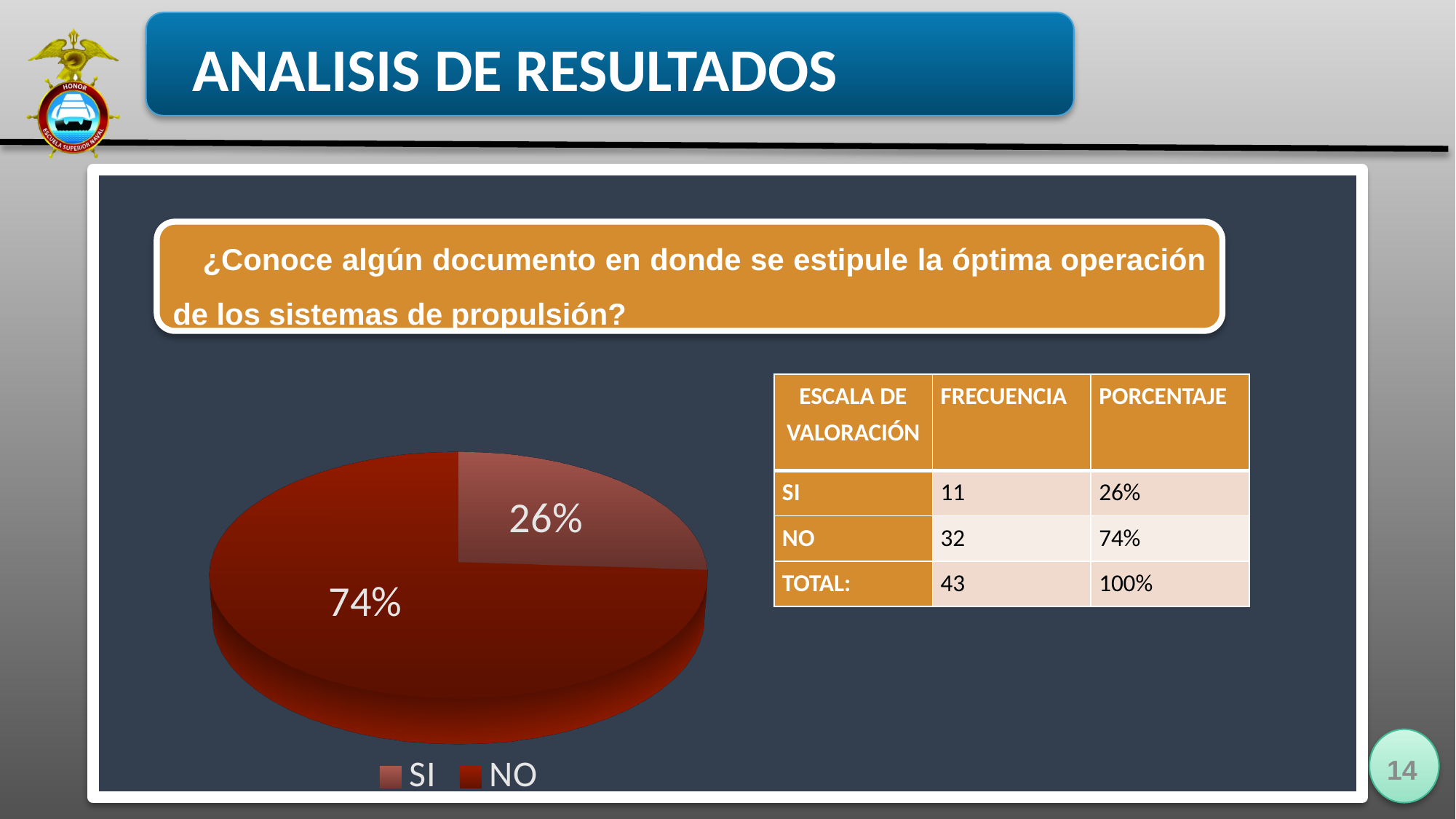
How many entries does the legend of the pie chart list? 2 What is the difference in percentage points between the NO slice and the SI slice? 48 Which legend entry is shown in the darker red colour? NO What percentage of the pie chart does the NO slice represent? 74% Which slice is larger, SI or NO? NO Which category has the smallest slice in the pie chart? SI Is the share of the NO slice greater or less than 50%? greater What kind of chart is shown on the slide? pie chart How many slices does the pie chart have? 2 Which category has the largest slice in the pie chart? NO What percentage of the pie chart does the SI slice represent? 26% What are the legend entries of the pie chart? SI, NO